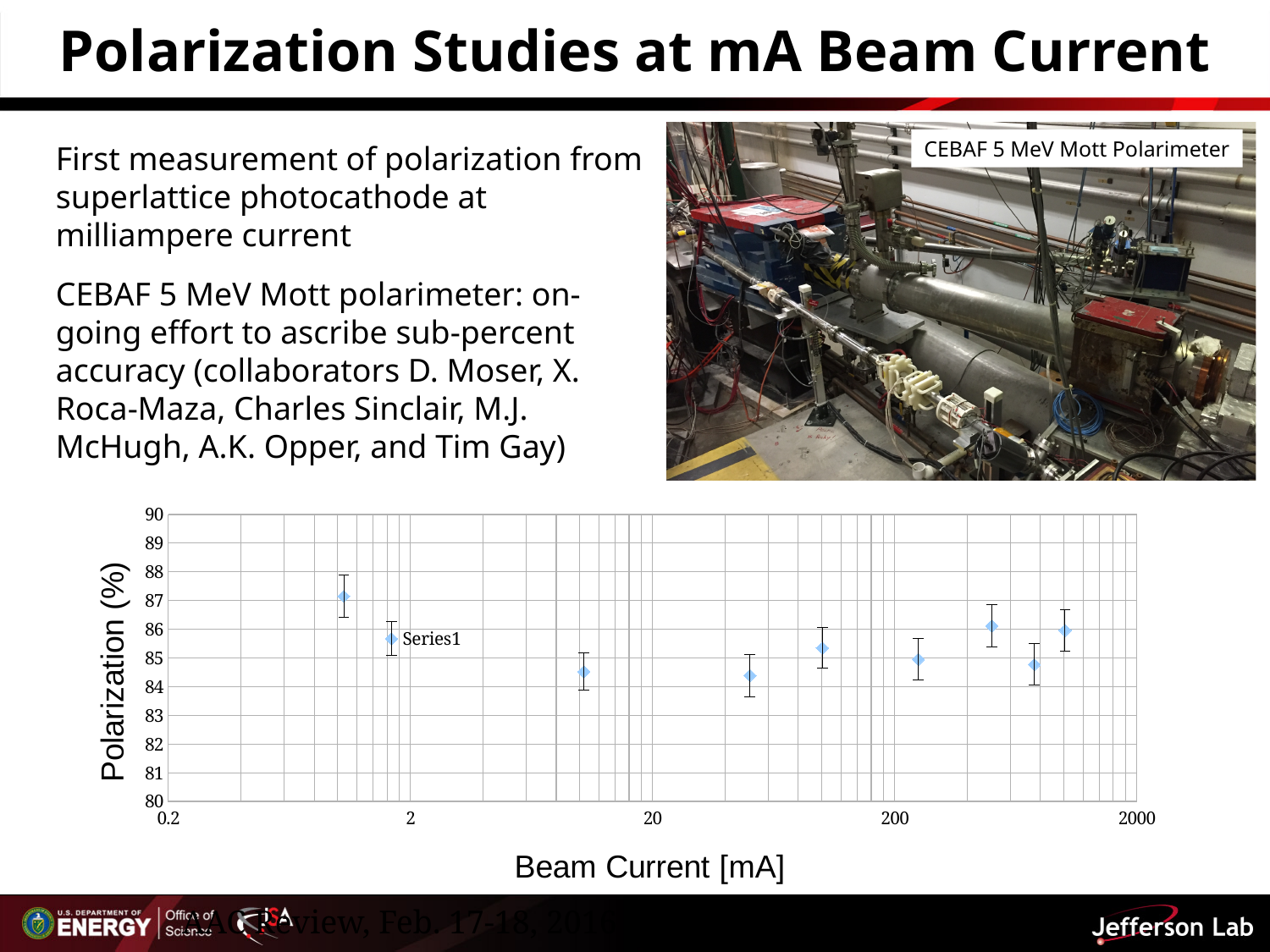
Are all plotted polarization values greater or less than 84? greater Which has the larger polarization value, the first data point or the second data point from the left? the first data point Is the polarization value of the leftmost data point greater or less than 86? greater How many data points are plotted in the chart? 9 Which data point has the highest polarization value? the leftmost point (near 1 mA) What is the label of the chart's x axis? Beam Current [mA] Is the polarization value of the data point near 8 mA greater or less than 85? less What kind of chart is shown at the bottom of the slide? scatter chart Do the polarization values rise or fall from the first data point to the third data point along the x axis? fall